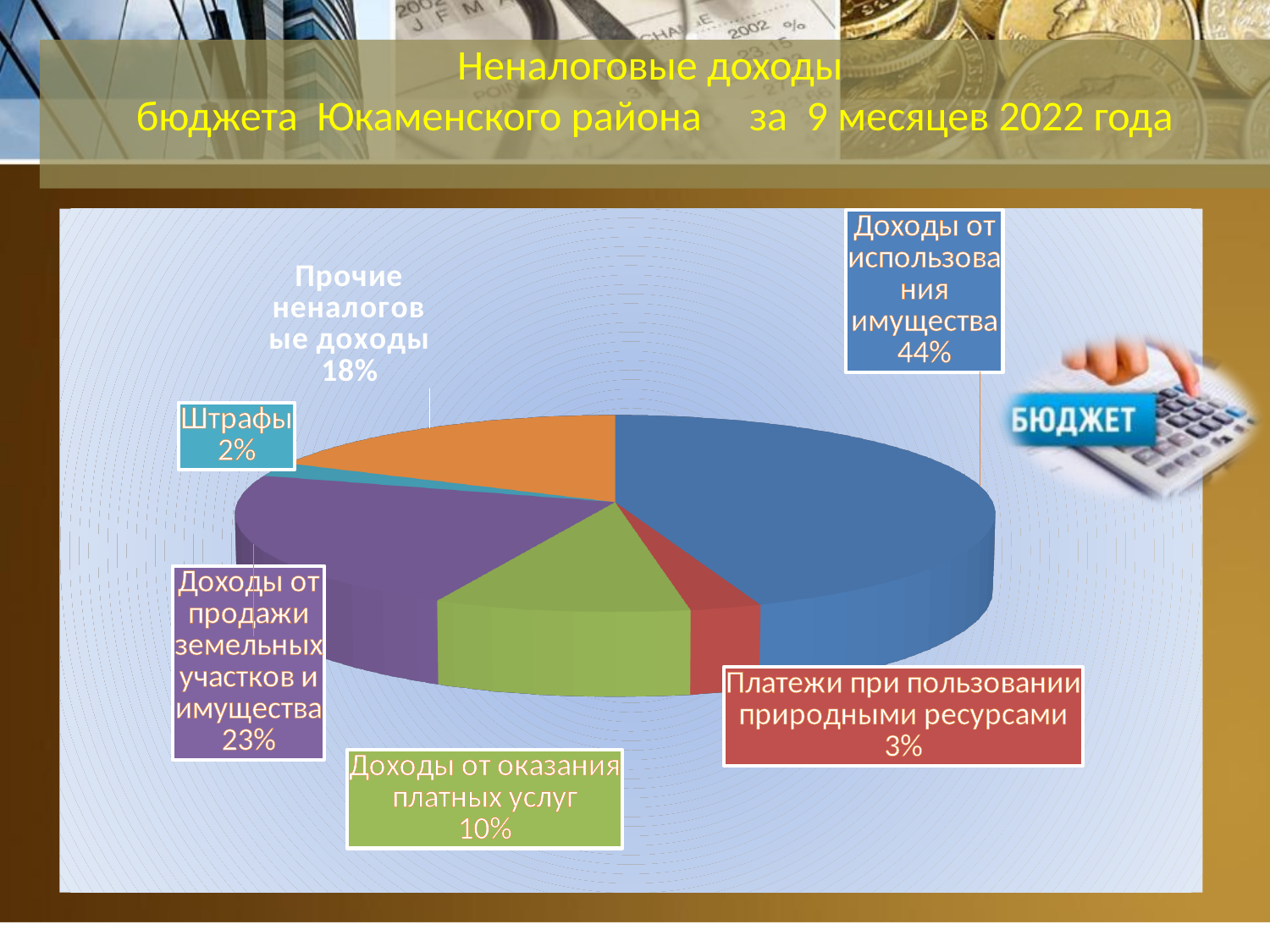
What share is shown for "Доходы от оказания платных услуг"? 10% What is the difference in percentage points between "Доходы от использования имущества" and "Доходы от продажи земельных участков и имущества"? 21 Which category has the largest share of the pie? Доходы от использования имущества What kind of chart is shown on the slide? Pie chart What share is shown for "Доходы от продажи земельных участков и имущества"? 23% What percentage is labelled for "Штрафы"? 2% What is the title of the slide containing the chart? Неналоговые доходы бюджета Юкаменского района за 9 месяцев 2022 года What share of non-tax revenues comes from "Доходы от использования имущества"? 44% Which is larger: the share for "Прочие неналоговые доходы" or the share for "Доходы от оказания платных услуг"? Прочие неналоговые доходы How many categories (slices) does the pie chart have? 6 What percentage is shown for "Платежи при пользовании природными ресурсами"? 3% Which category has the smallest share of the pie? Штрафы